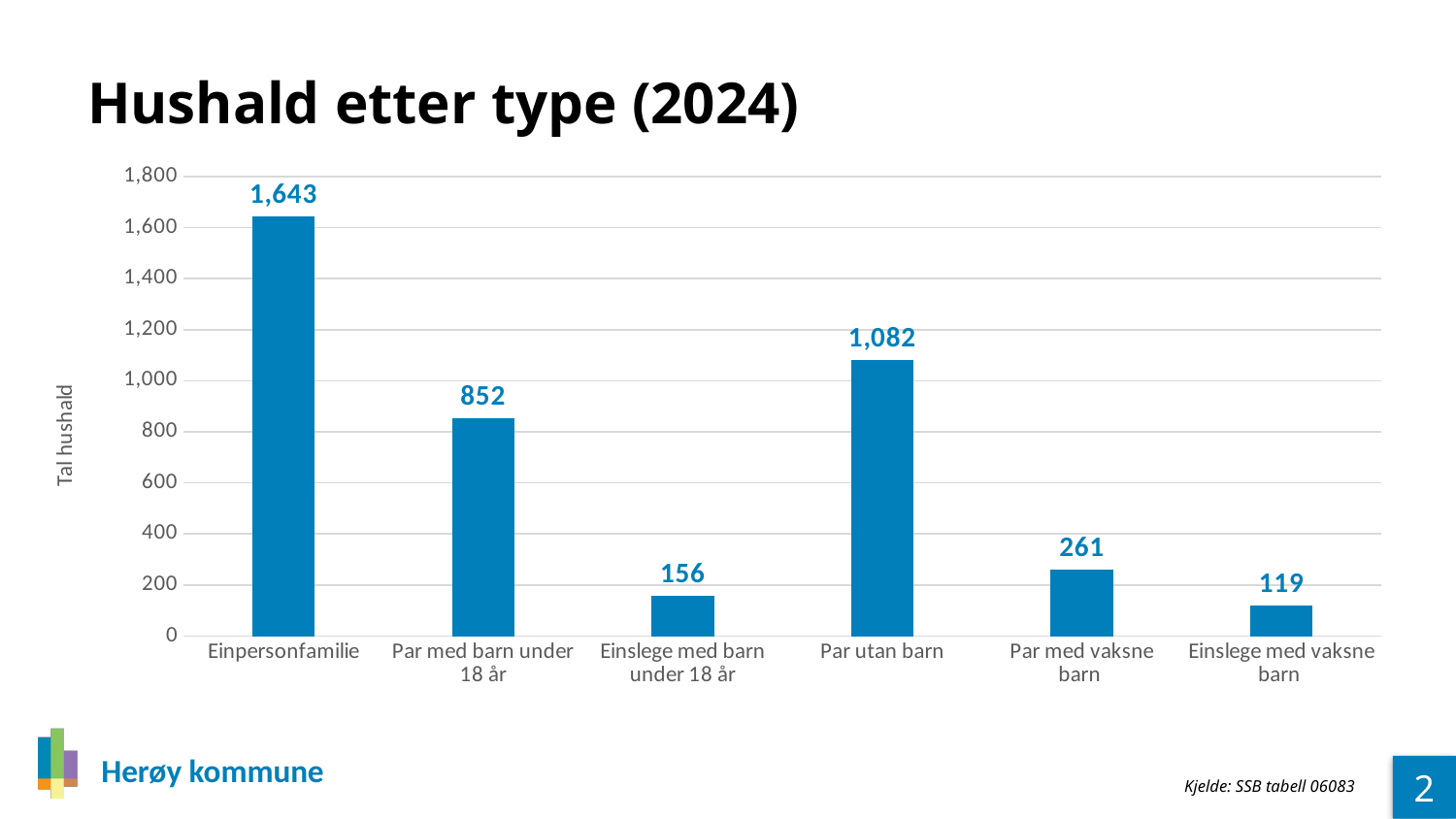
What is the value for Par med vaksne barn? 261 Which household type has the highest value? Einpersonfamilie What is the value for Par utan barn? 1,082 What is the value for Einslege med barn under 18 år? 156 What is the value for Einpersonfamilie? 1,643 Which household type has the lowest value? Einslege med vaksne barn Which is larger, Par med barn under 18 år or Par utan barn? Par utan barn What is the difference between Einpersonfamilie and Par utan barn? 561 How many household types are shown in the chart? 6 What kind of chart is shown on the slide? Bar chart What is the difference between Par med vaksne barn and Einslege med vaksne barn? 142 What is the title of the chart? Hushald etter type (2024)